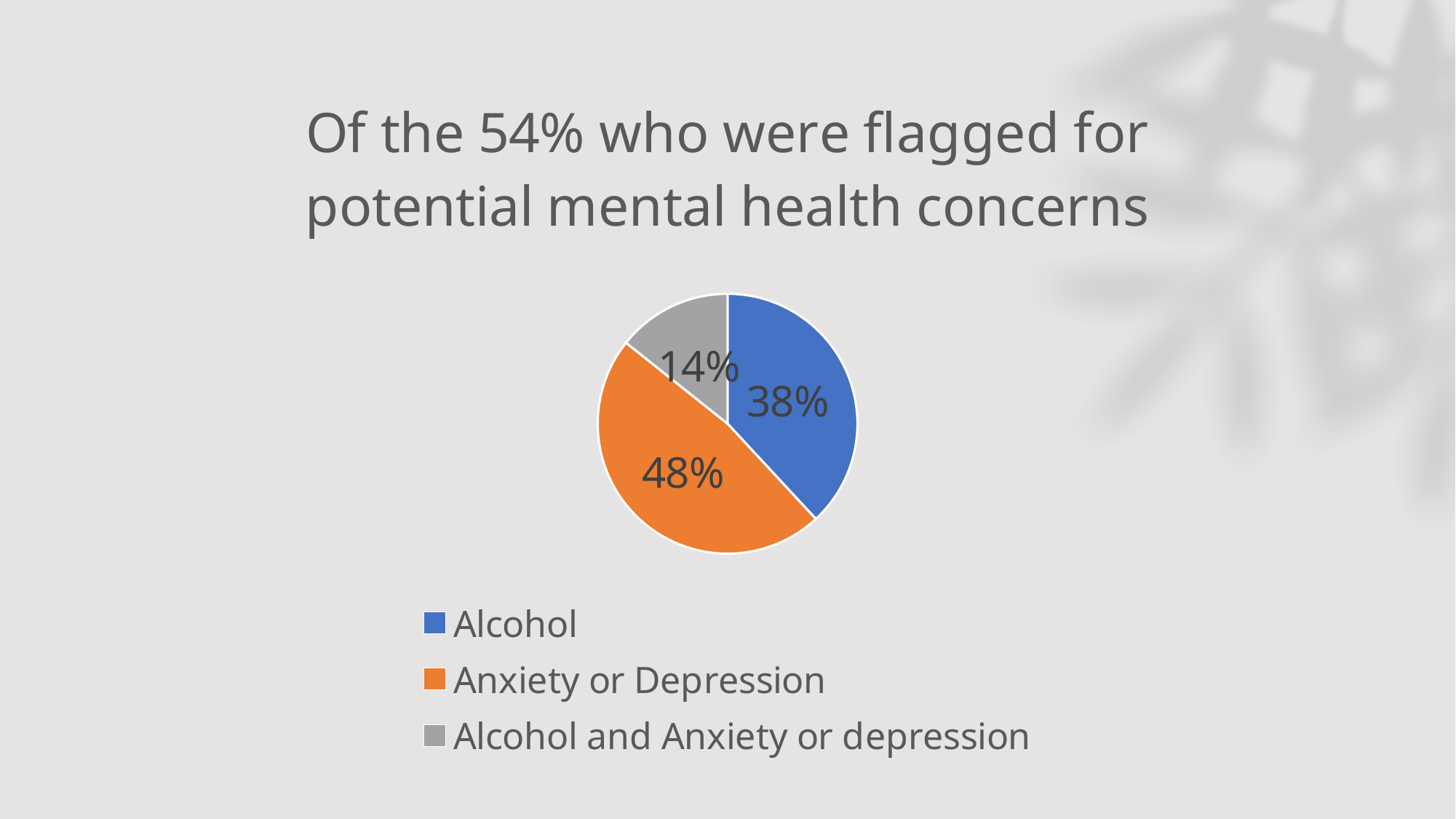
What is the difference in percentage points between the Anxiety or Depression slice and the Alcohol slice? 10 What is the title of the chart? Of the 54% who were flagged for potential mental health concerns Which is larger, the Alcohol slice or the Alcohol and Anxiety or depression slice? Alcohol Which category has the largest slice of the pie? Anxiety or Depression What colour is the slice for Anxiety or Depression? orange What kind of chart is shown on the slide? pie chart What share of the pie is labelled for Alcohol? 38% How many slices does the pie chart have? 3 What share of the pie is labelled for Anxiety or Depression? 48% What share of the pie is labelled for Alcohol and Anxiety or depression? 14% Which category has the smallest slice of the pie? Alcohol and Anxiety or depression How many entries does the legend list? 3